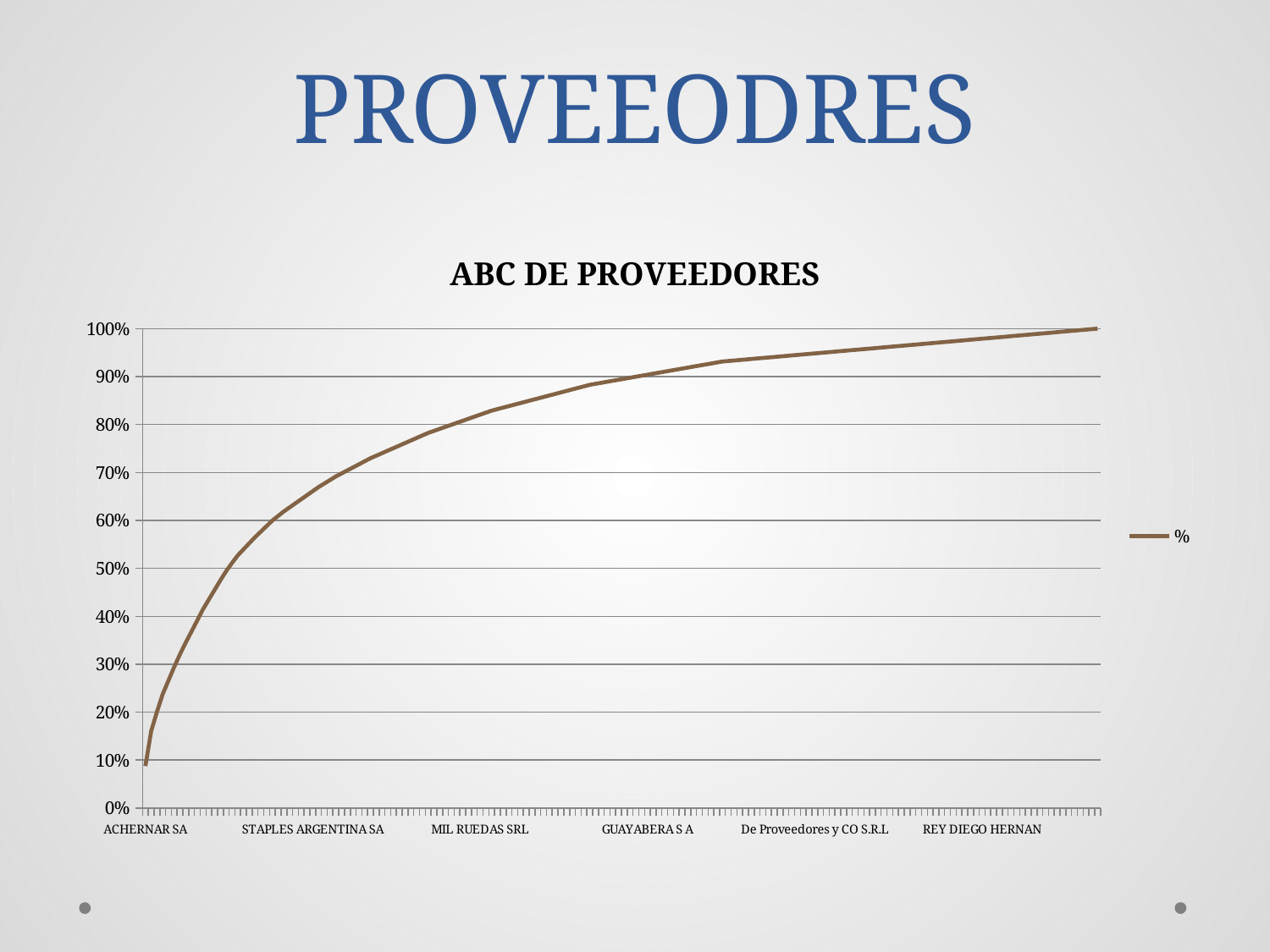
Is the value for STAPLES ARGENTINA SA greater or less than 50%? greater Is the value for GUAYABERA S A greater or less than 80%? greater What is the title of the chart? ABC DE PROVEEDORES What is the highest value the line reaches? 100% Which has the larger value, ACHERNAR SA or REY DIEGO HERNAN? REY DIEGO HERNAN What kind of chart is shown on the slide? line chart How many series does the legend list? 1 What is the legend entry for the plotted line? % Is the value for REY DIEGO HERNAN greater or less than 90%? greater Do the values rise or fall along the x axis? rise